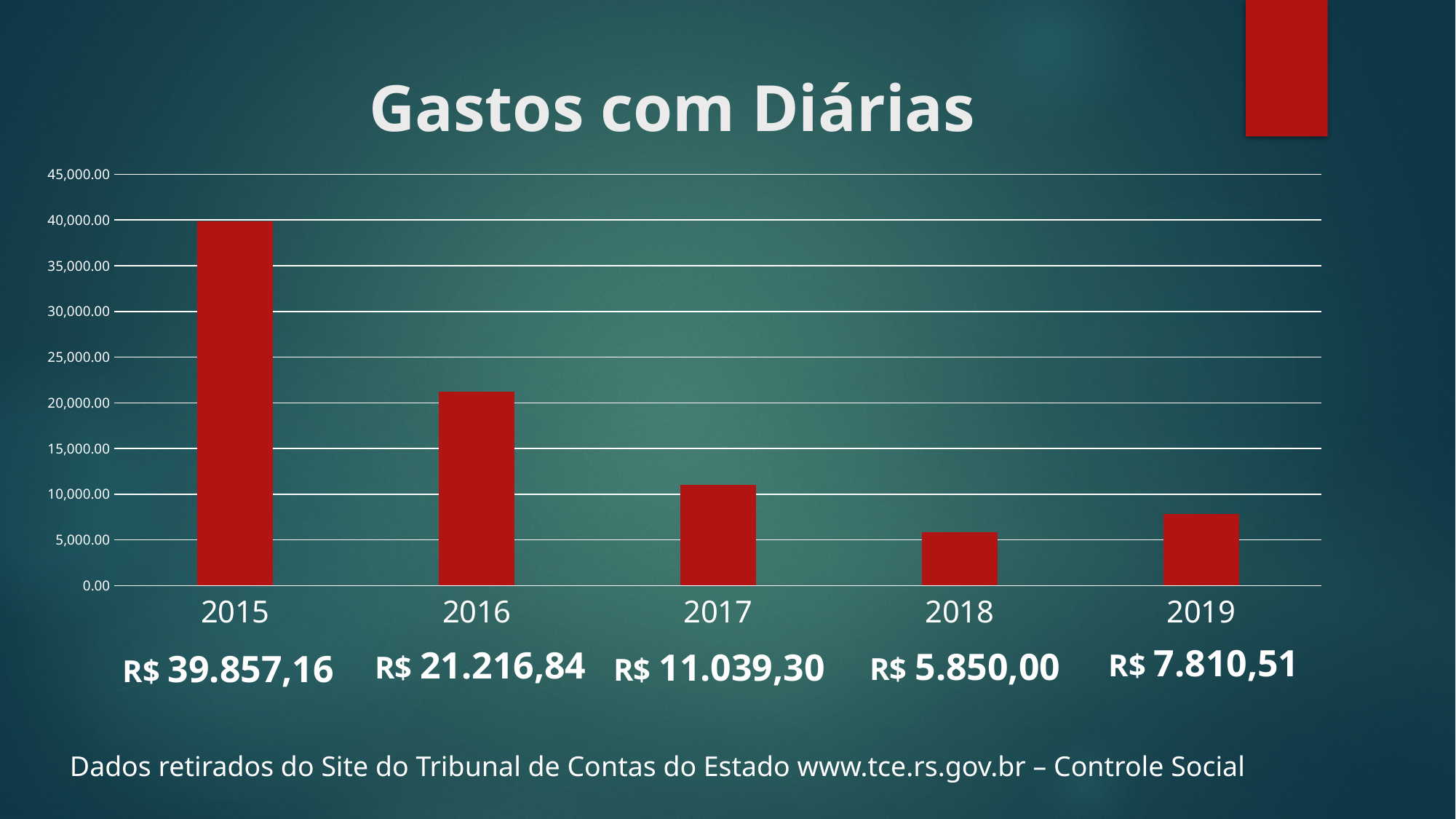
Is the value for 2016 greater or less than 25,000.00? less What kind of chart is shown on the slide? bar chart What is the value for 2015? R$ 39.857,16 What is the difference between the values for 2019 and 2018? R$ 1.960,51 Do the values rise or fall from 2015 to 2018? fall Which year has the lowest spending on diárias? 2018 Which is larger, the value for 2017 or the value for 2019? 2017 What is the value for 2018? R$ 5.850,00 What is the value for 2019? R$ 7.810,51 How many years are shown on the x axis? 5 What is the difference between the values for 2015 and 2016? R$ 18.640,32 Which year has the highest spending on diárias? 2015